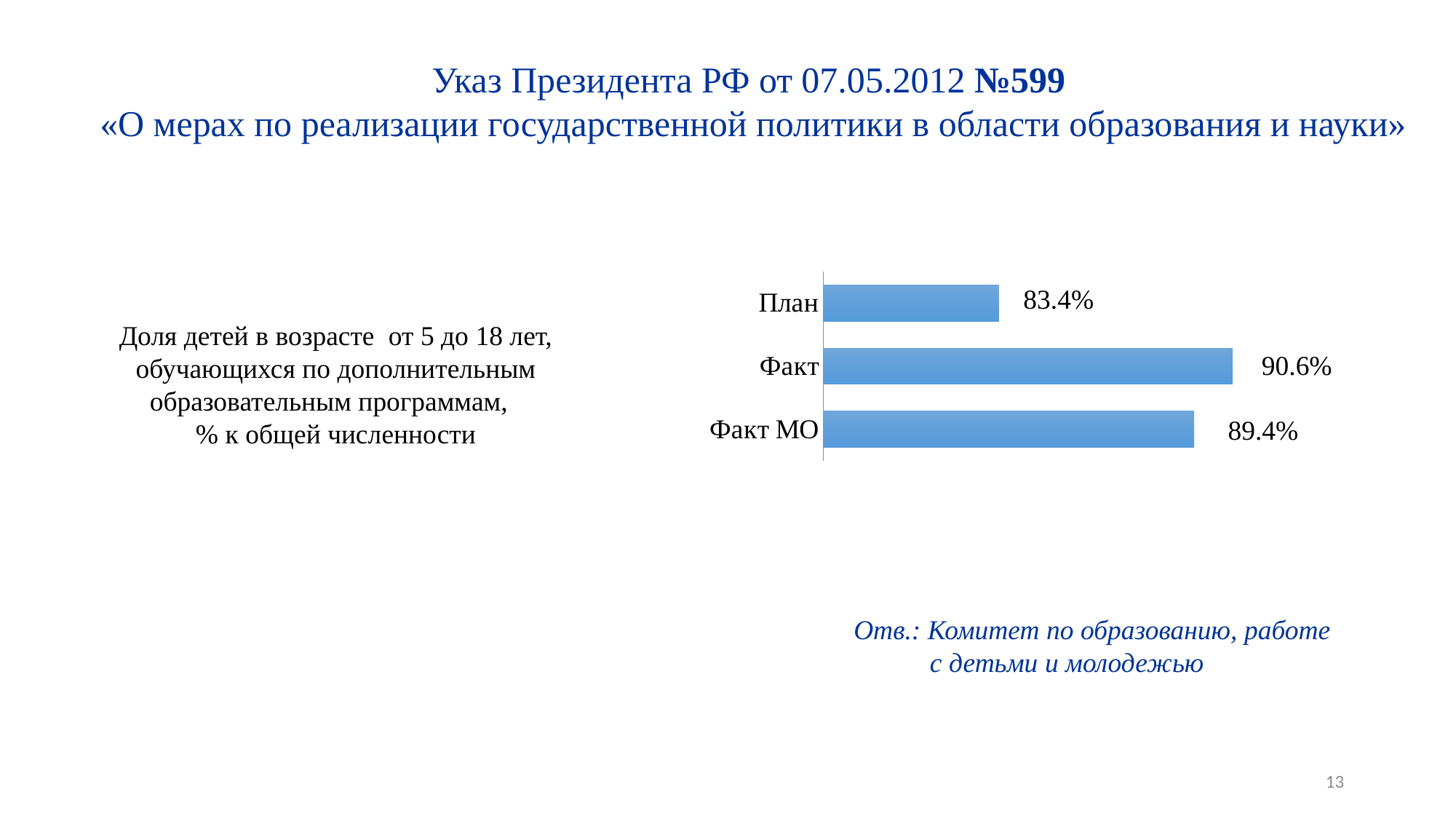
How many categories are shown in the chart? 3 Which category has the lowest value? План What kind of chart is shown on the slide? Bar chart Which is larger, the value for Факт МО or the value for План? Факт МО Which category has the highest value? Факт What is the difference between the values for Факт and Факт МО? 1.2% What is the value for Факт? 90.6% What is the difference between the values for Факт and План? 7.2% What is the value for Факт МО? 89.4% Which category is listed at the top of the chart? План What colour are the bars in the chart? Blue What is the value for План? 83.4%